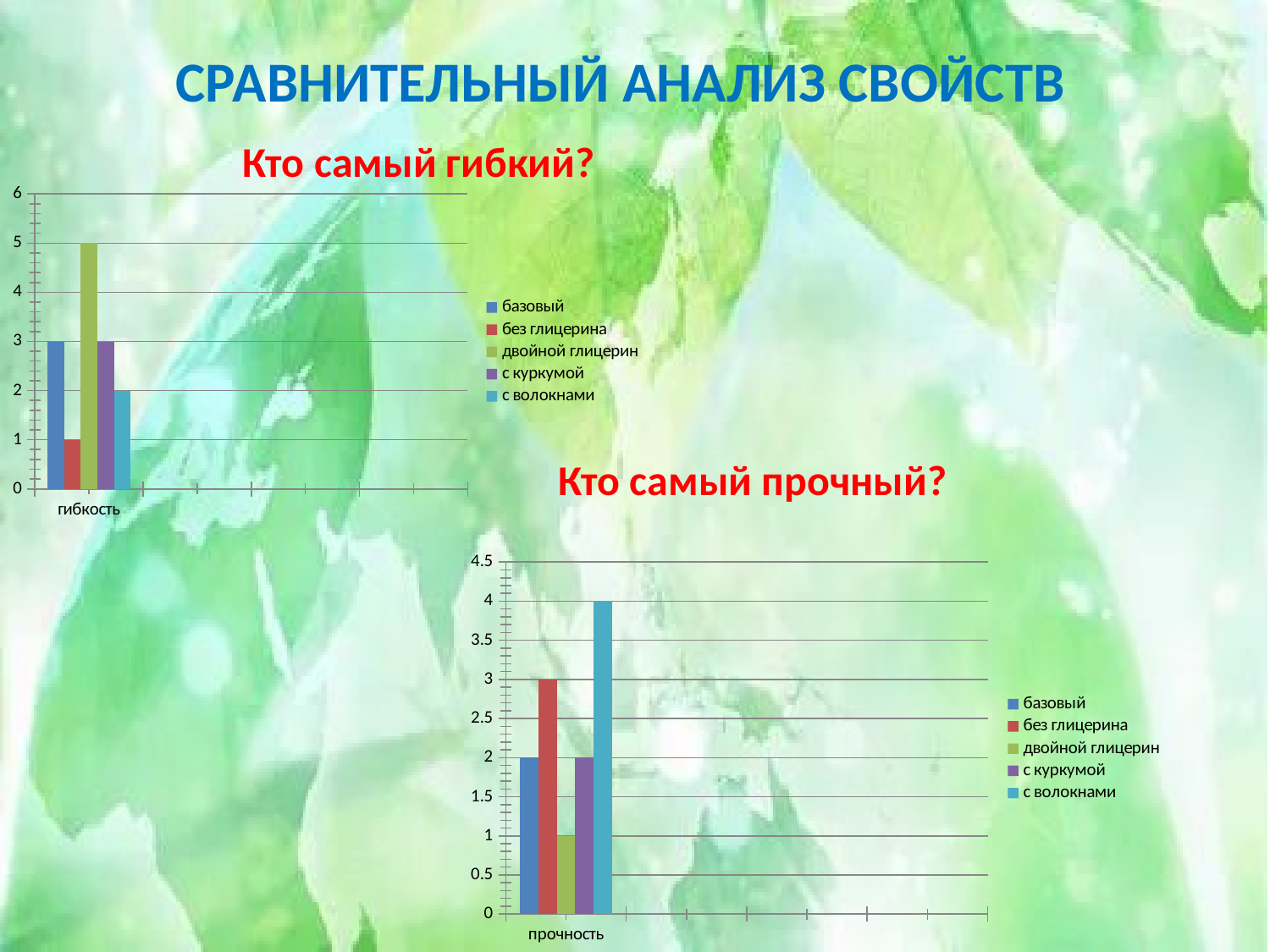
In the strength chart (прочность, bottom right), what is the value for без глицерина? 3 In the strength chart (прочность, bottom right), is the value for с волокнами greater or less than 3.5? greater What kind of chart is the strength chart (прочность, bottom right)? bar chart In the strength chart (прочность, bottom right), which is larger, the value for базовый or the value for с волокнами? с волокнами In the flexibility chart (гибкость, top left), which series has the highest value? двойной глицерин In the flexibility chart (гибкость, top left), what is the value for двойной глицерин? 5 In the flexibility chart (гибкость, top left), what is the difference between the values for двойной глицерин and без глицерина? 4 In the strength chart (прочность, bottom right), which series has the lowest value? двойной глицерин In the flexibility chart (гибкость, top left), what is the value for с волокнами? 2 In the strength chart (прочность, bottom right), which series has the highest value? с волокнами In the flexibility chart (гибкость, top left), how many series does the legend list? 5 In the flexibility chart (гибкость, top left), which series has the lowest value? без глицерина